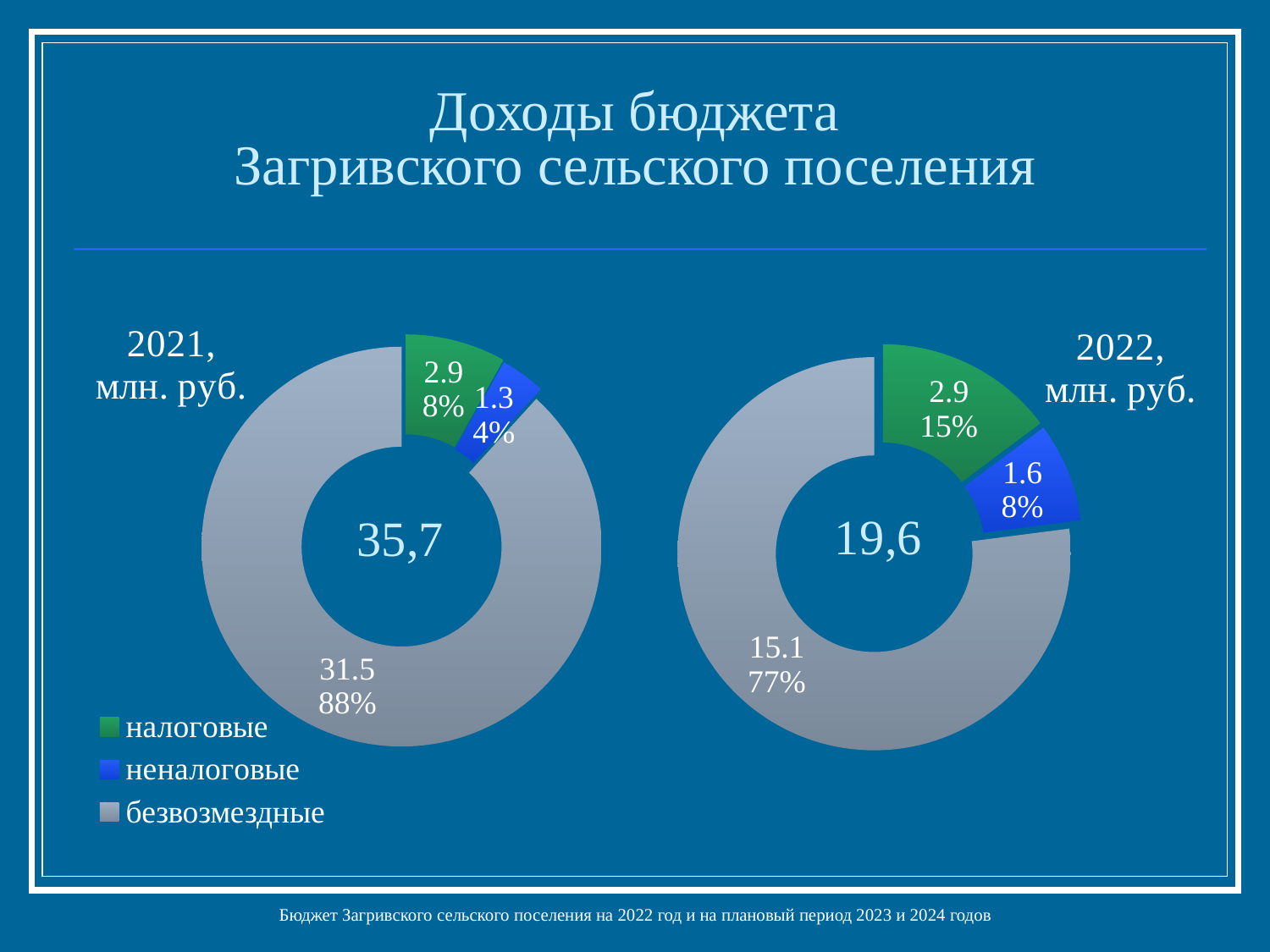
Which is larger: неналоговые in the 2021 chart or неналоговые in the 2022 chart? 2022 In the 2021 chart, which category has the largest value? безвозмездные What type of chart is used on this slide? doughnut chart In the 2022 chart, what is the value for неналоговые? 1.6 How many categories does each chart show? 3 In the 2021 chart, what share of the total do неналоговые make up? 4% In the 2022 chart, what share of the total do налоговые make up? 15% In the 2021 chart, what is the value for безвозмездные? 31.5 In the 2022 chart, which category has the smallest value? неналоговые What is the difference between безвозмездные in the 2021 chart and безвозмездные in the 2022 chart? 16.4 What total is shown in the centre of the 2022 chart? 19,6 Which colour represents налоговые in the legend? green